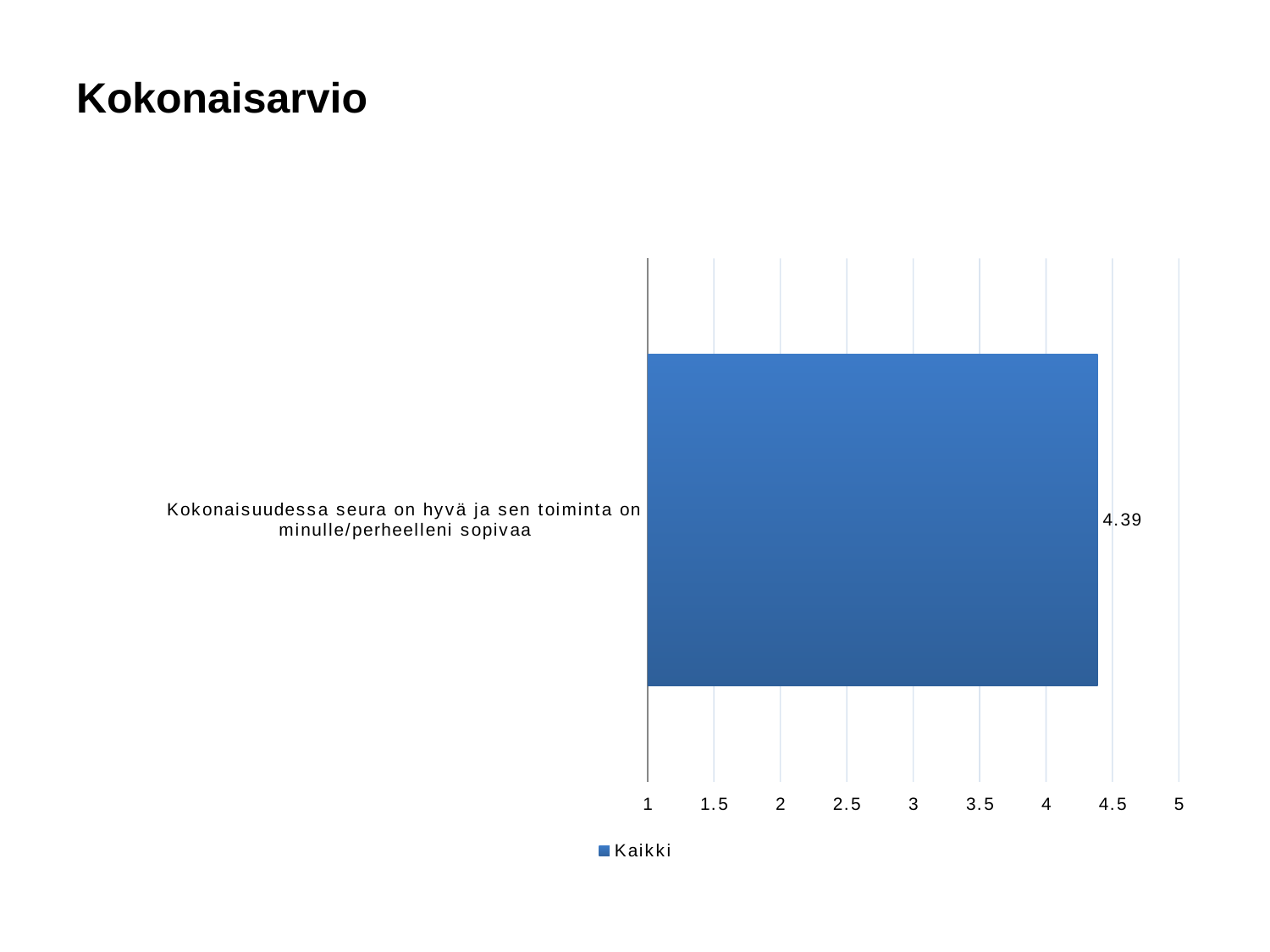
What kind of chart is shown on the slide? bar chart Is the value for "Kokonaisuudessa seura on hyvä ja sen toiminta on minulle/perheelleni sopivaa" greater or less than 4? greater Is the value for "Kokonaisuudessa seura on hyvä ja sen toiminta on minulle/perheelleni sopivaa" greater or less than 4.5? less How many categories are plotted in the chart? 1 What is the value for "Kokonaisuudessa seura on hyvä ja sen toiminta on minulle/perheelleni sopivaa"? 4.39 What is the highest value shown on the x axis? 5 What is the title of the slide? Kokonaisarvio What is the lowest value shown on the x axis? 1 What is the name of the series shown in the legend? Kaikki How many series does the legend list? 1